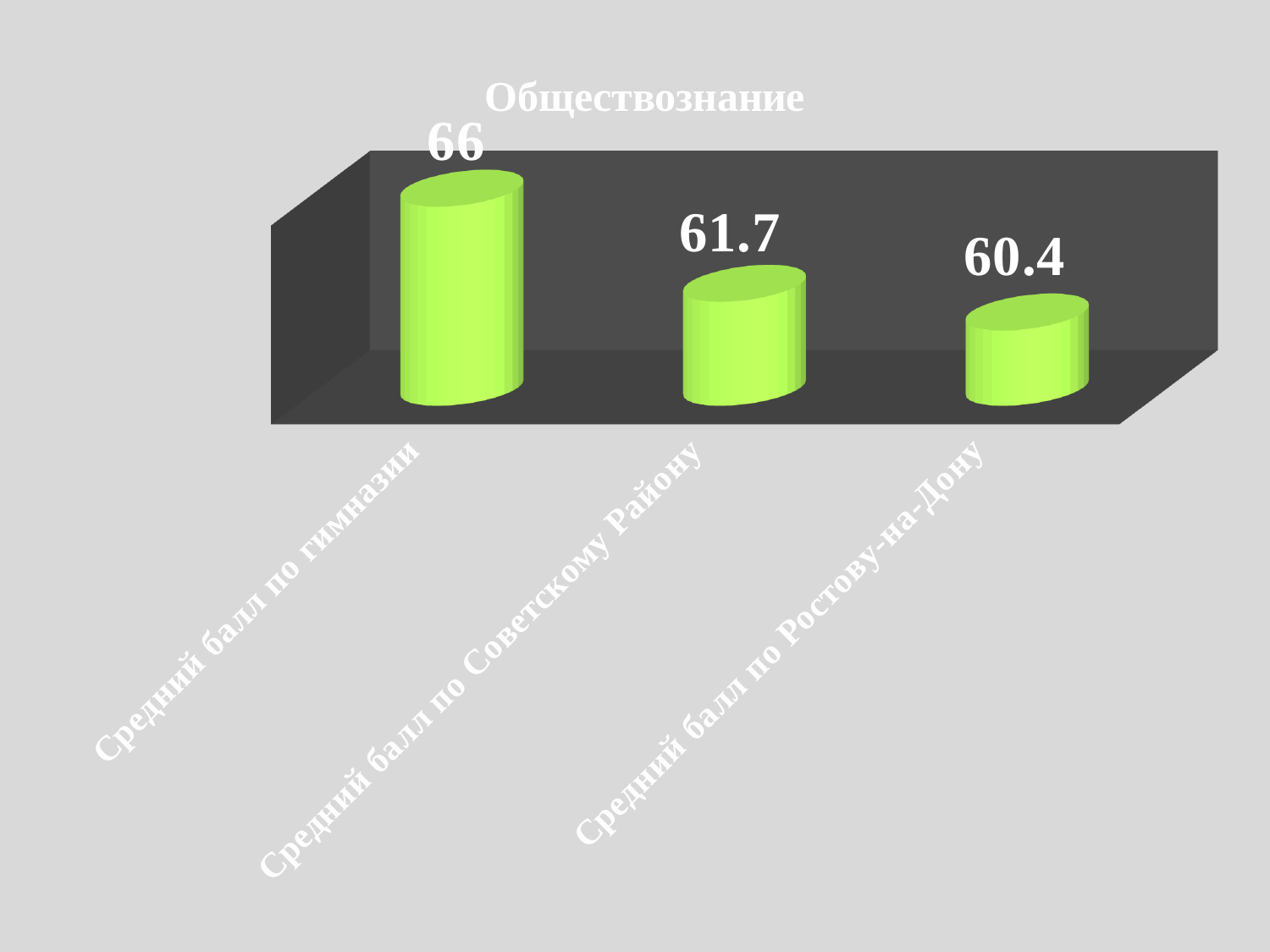
Which category has the lowest value? Средний балл по Ростову-на-Дону How many categories are shown in the chart? 3 What is the value for "Средний балл по Ростову-на-Дону"? 60.4 Which category has the highest value? Средний балл по гимназии What is the value for "Средний балл по Советскому Району"? 61.7 What is the difference between the value for "Средний балл по гимназии" and the value for "Средний балл по Советскому Району"? 4.3 Which is larger: the value for "Средний балл по гимназии" or the value for "Средний балл по Ростову-на-Дону"? Средний балл по гимназии What is the title of the chart? Обществознание What is the value for "Средний балл по гимназии"? 66 What kind of chart is shown on the slide? Bar chart What is the difference between the value for "Средний балл по Советскому Району" and the value for "Средний балл по Ростову-на-Дону"? 1.3 Do the values rise or fall from left to right across the categories? Fall